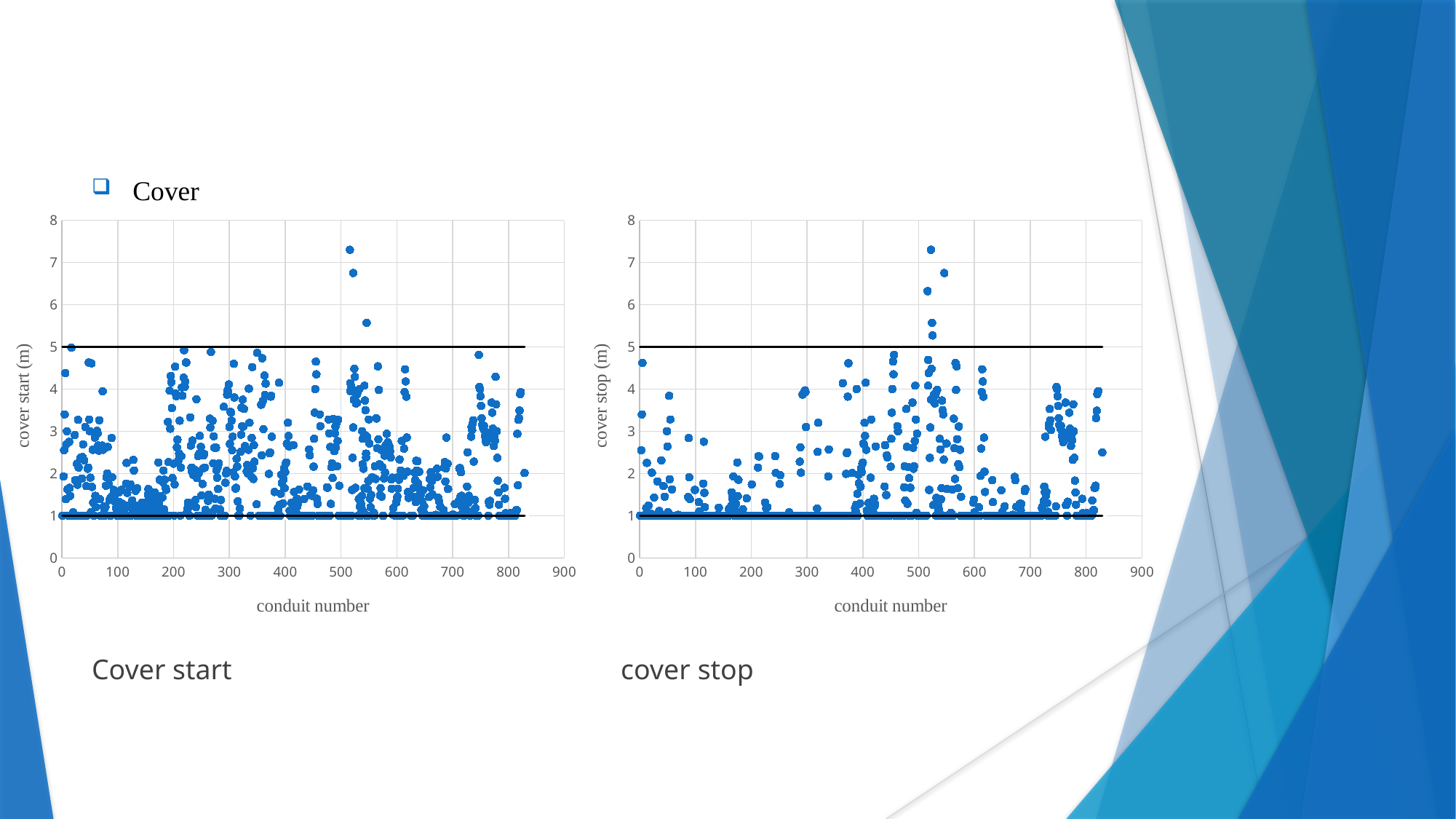
On the right chart (cover stop), are most of the plotted points above or below the horizontal line at 5? below On the left chart (Cover start), what is the maximum value shown on the y axis? 8 On the right chart (cover stop), at what y-axis value is the lower horizontal black line drawn? 1 On the right chart (cover stop), what is the maximum value shown on the x axis? 900 On the right chart (cover stop), what is the label of the y axis? cover stop (m) On the left chart (Cover start), what is the label of the x axis? conduit number On the left chart (Cover start), at what y-axis value is the upper horizontal black line drawn? 5 On the left chart (Cover start), is the highest plotted point greater or less than the upper horizontal line at 5? greater What kind of chart is the right chart labelled "cover stop"? scatter chart On the right chart (cover stop), is the highest plotted point greater or less than 7? greater What kind of chart is the left chart labelled "Cover start"? scatter chart